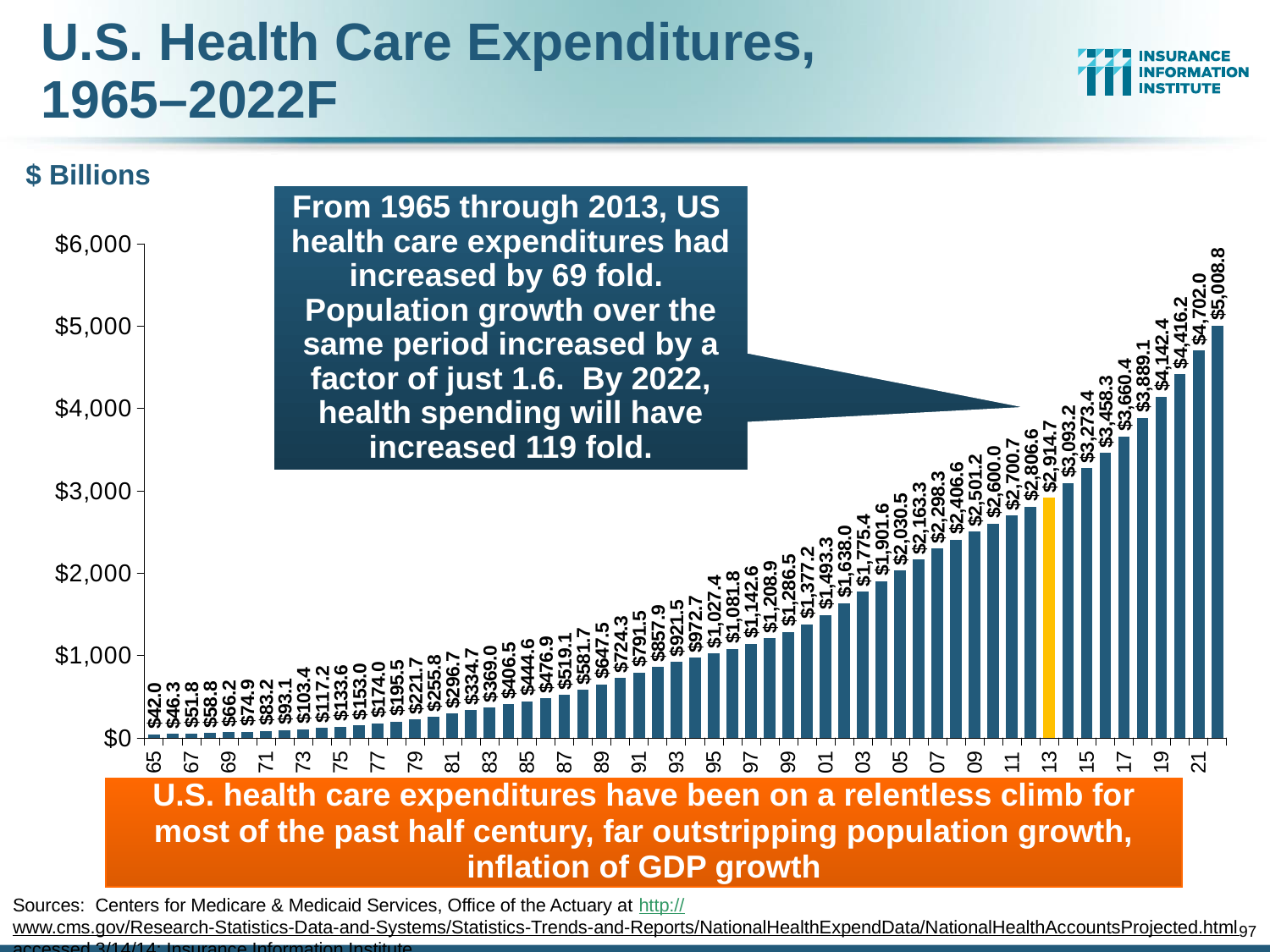
What is the difference between the 2022 value and the 1965 value? $4,966.8 What is the value shown for 2022 (the last bar)? $5,008.8 Which year has the lowest health care expenditure value? 1965 Which year has the highest health care expenditure value? 2022 What is the value shown for 2001? $1,493.3 Is the value for 2009 greater or less than $2,000? greater What is the value of the highlighted (yellow) bar for 2013? $2,914.7 How many bars (years) are plotted in the chart? 58 What type of chart is shown on the slide? Bar chart Do the values generally rise or fall from 1965 to 2022? Rise Which is larger, the value for 1999 or the value for 2001? 2001 What is the value of U.S. health care expenditures for 1965 (the first bar)? $42.0